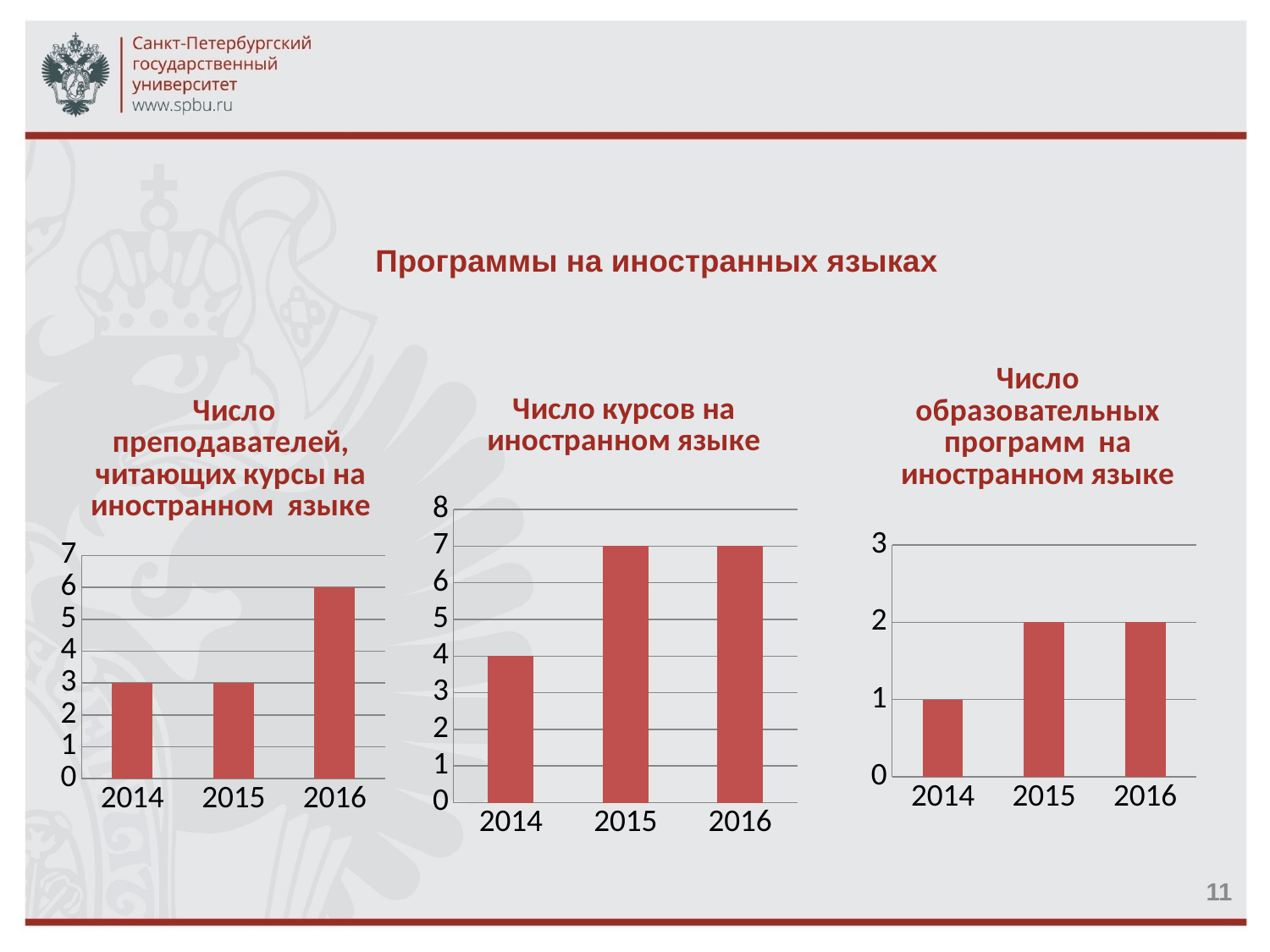
In the chart 'Число курсов на иностранном языке', what is the difference between the values for 2015 and 2014? 3 In the chart 'Число курсов на иностранном языке', what is the value for 2014? 4 In the chart 'Число образовательных программ на иностранном языке', which year has the lowest value? 2014 In the chart 'Число курсов на иностранном языке', is the value for 2015 larger or smaller than the value for 2014? larger In the chart 'Число образовательных программ на иностранном языке', what is the value for 2015? 2 In the chart 'Число курсов на иностранном языке', which year has the lowest value? 2014 In the chart 'Число преподавателей, читающих курсы на иностранном языке', which year has the highest value? 2016 How many years are shown on the x axis of the chart 'Число образовательных программ на иностранном языке'? 3 What type of chart is 'Число курсов на иностранном языке'? bar chart In the chart 'Число преподавателей, читающих курсы на иностранном языке', what is the value for 2016? 6 How many charts are shown on the slide? 3 In the chart 'Число преподавателей, читающих курсы на иностранном языке', what is the difference between the values for 2016 and 2015? 3